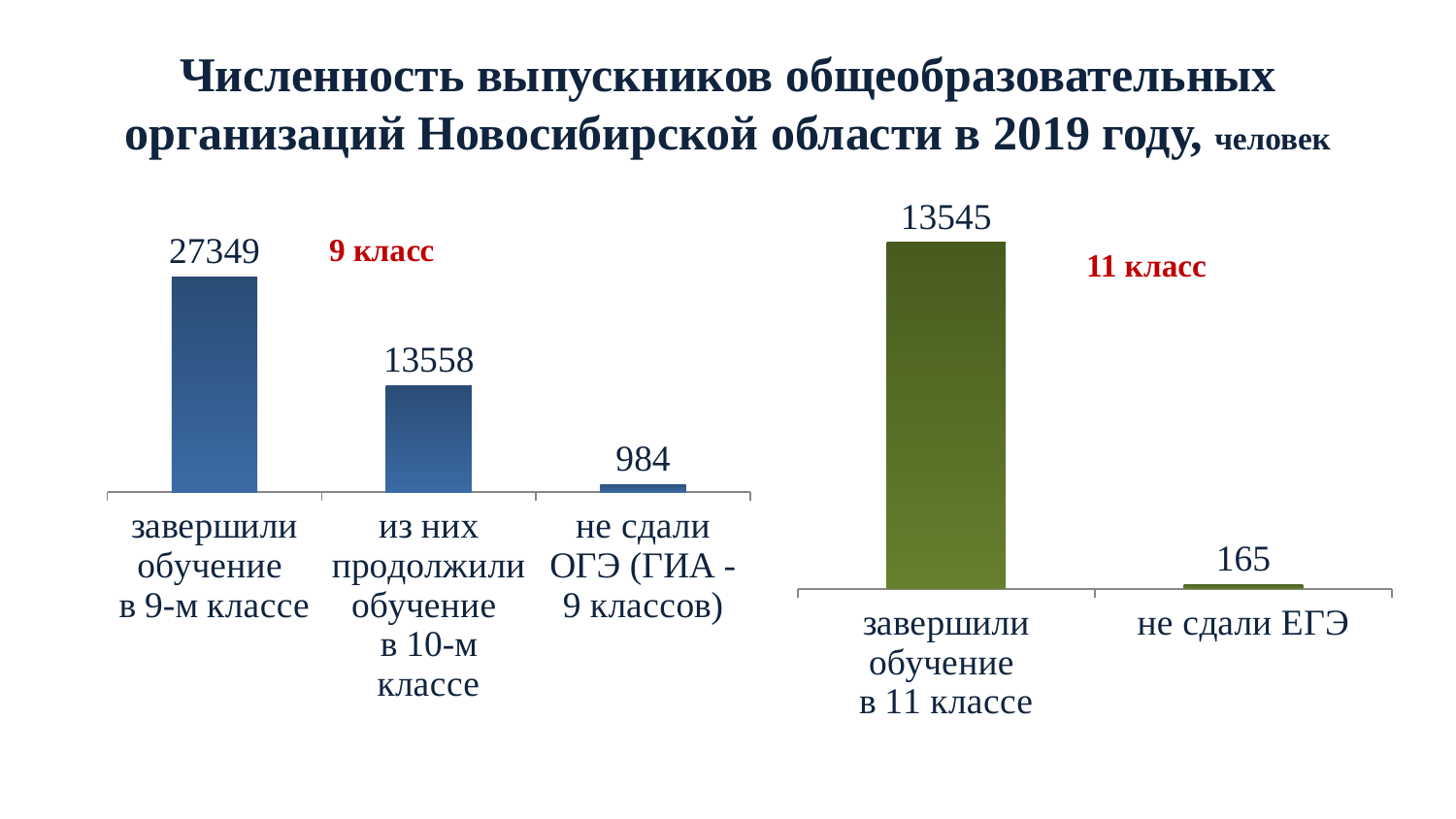
In the 9 класс chart, which category has the highest value? завершили обучение в 9-м классе What kind of chart is the 11 класс chart? bar chart In the 11 класс chart, what is the difference between завершили обучение в 11 классе and не сдали ЕГЭ? 13380 How many categories does the 9 класс chart show? 3 In the 9 класс chart, which category has the lowest value? не сдали ОГЭ (ГИА - 9 классов) In the 11 класс chart, what is the value for завершили обучение в 11 классе? 13545 In the 9 класс chart, what is the value for из них продолжили обучение в 10-м классе? 13558 In the 9 класс chart, what is the value for завершили обучение в 9-м классе? 27349 Which is larger: из них продолжили обучение в 10-м классе in the 9 класс chart or завершили обучение в 11 классе in the 11 класс chart? из них продолжили обучение в 10-м классе In the 9 класс chart, what is the difference between завершили обучение в 9-м классе and из них продолжили обучение в 10-м классе? 13791 In the 11 класс chart, what is the value for не сдали ЕГЭ? 165 In the 9 класс chart, what is the value for не сдали ОГЭ (ГИА - 9 классов)? 984